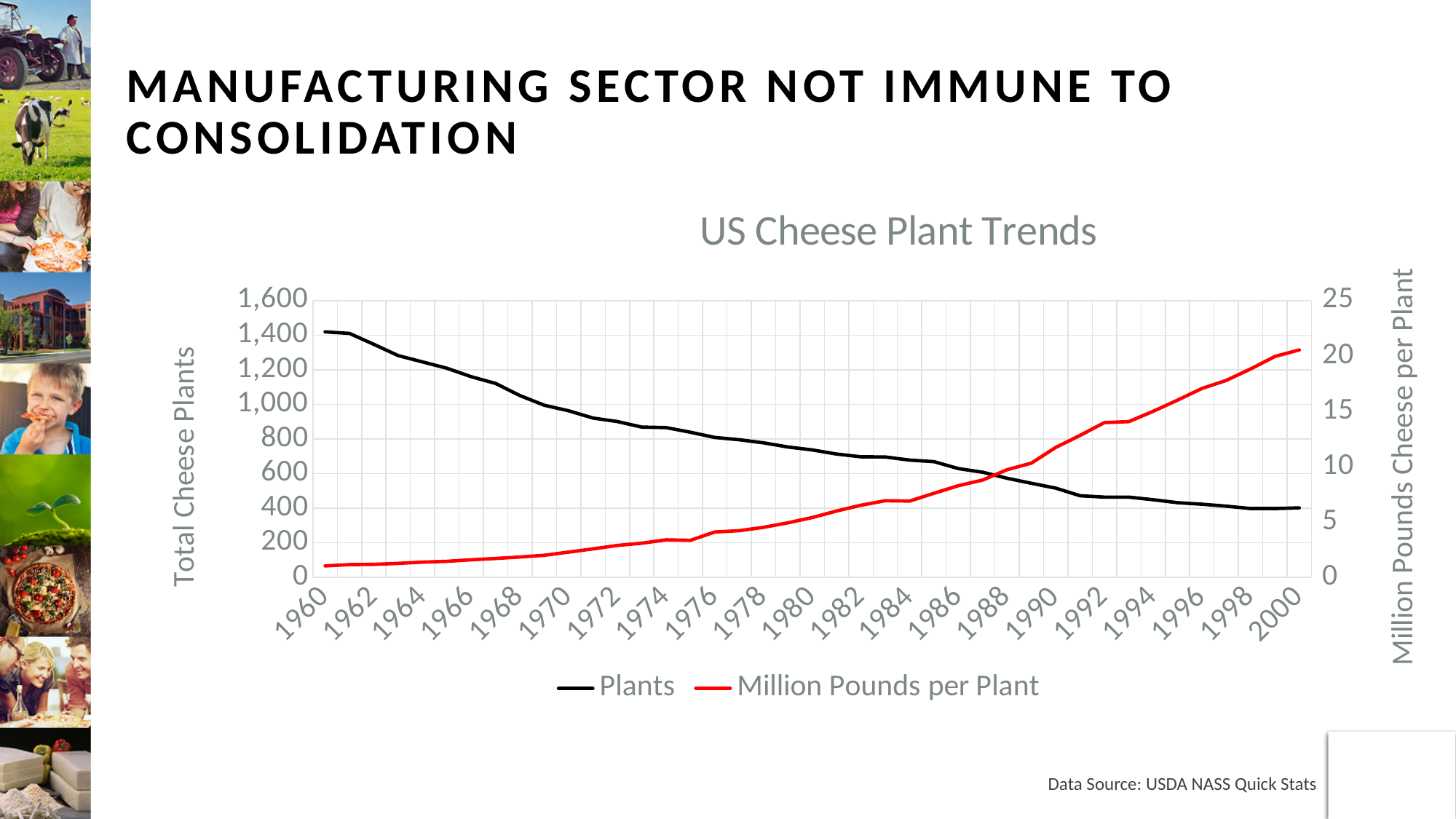
What kind of chart is shown on the slide? Line chart How many series does the legend of the US Cheese Plant Trends chart list? 2 Does the Plants series rise or fall from 1960 to 2000? Fall Does the Million Pounds per Plant series rise or fall from 1960 to 2000? Rise Is the value for Plants in 2000 greater or less than 600? less What is the title of the chart? US Cheese Plant Trends What is the label of the left vertical axis? Total Cheese Plants Is the value for Million Pounds per Plant in 2000 greater or less than 15? greater In which year is the Million Pounds per Plant series at its lowest? 1960 In which year is the Plants series at its highest? 1960 Is the value for Plants in 1960 greater or less than 1,200? greater Which is larger, the Plants value in 1960 or the Plants value in 2000? 1960